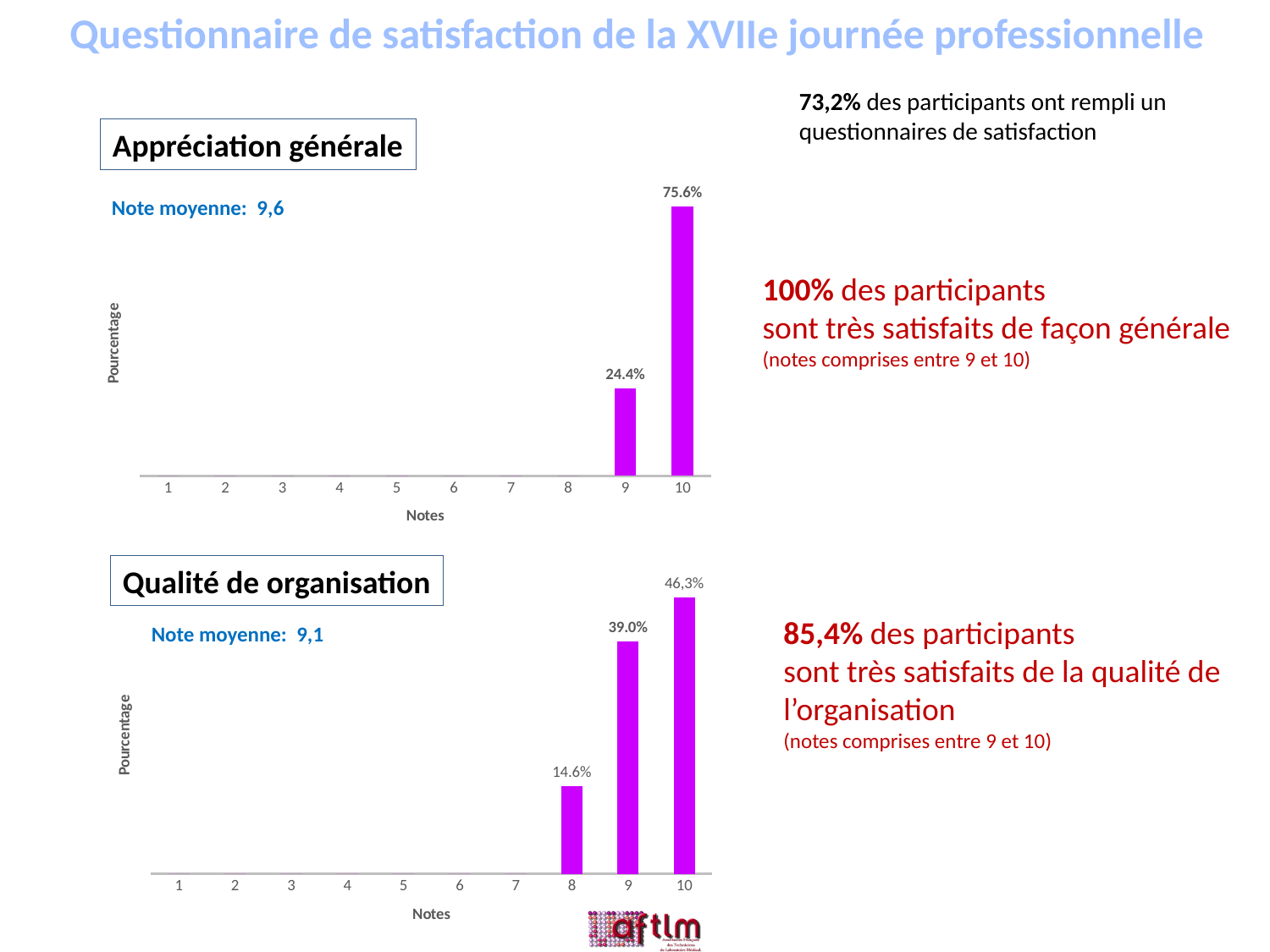
In the 'Qualité de organisation' chart, what percentage is shown for note 8? 14.6% In the 'Appréciation générale' chart, which note has the highest percentage? 10 In the 'Qualité de organisation' chart, what percentage is shown for note 10? 46,3% In the 'Qualité de organisation' chart, what percentage is shown for note 9? 39.0% In the 'Appréciation générale' chart, what percentage is shown for note 9? 24.4% In the 'Appréciation générale' chart, what is the difference between the percentages for note 10 and note 9? 51.2% In the 'Appréciation générale' chart, what percentage is shown for note 10? 75.6% In the 'Qualité de organisation' chart, what is the difference between the percentages for note 9 and note 8? 24.4% In the 'Qualité de organisation' chart, which note has the highest percentage? 10 What kind of chart is the 'Qualité de organisation' chart? bar chart How many notes are listed on the x axis of the 'Appréciation générale' chart? 10 In the 'Qualité de organisation' chart, which is larger, the percentage for note 9 or for note 8? note 9